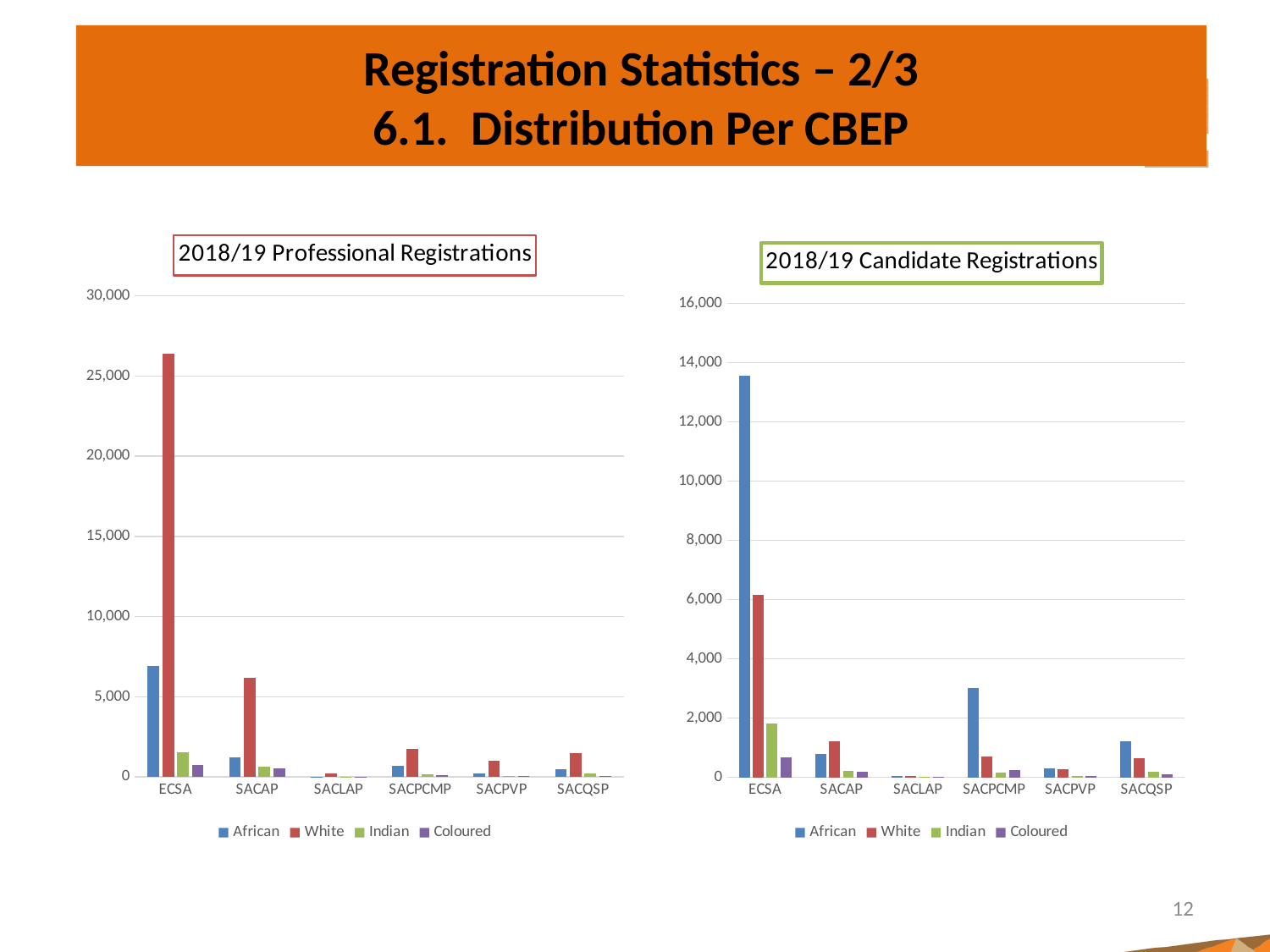
In the 2018/19 Candidate Registrations chart, which is larger for SACPCMP: the African value or the White value? African How many series does the legend of the 2018/19 Professional Registrations chart list? 4 How many CBEP categories are shown on the x axis of the 2018/19 Professional Registrations chart? 6 In the 2018/19 Candidate Registrations chart, is the African value for ECSA greater or less than 12,000? greater In the 2018/19 Candidate Registrations chart, is the White value for ECSA greater or less than 8,000? less In the 2018/19 Professional Registrations chart, is the White value for ECSA greater or less than 25,000? greater In the 2018/19 Professional Registrations chart, which CBEP has the tallest bar overall? ECSA What kind of chart is the 2018/19 Candidate Registrations chart? bar chart What colour represents the White series in the legend of the 2018/19 Candidate Registrations chart? red In the 2018/19 Candidate Registrations chart, which series has the tallest bar for ECSA? African In the 2018/19 Professional Registrations chart, which is larger for SACAP: the African value or the White value? White